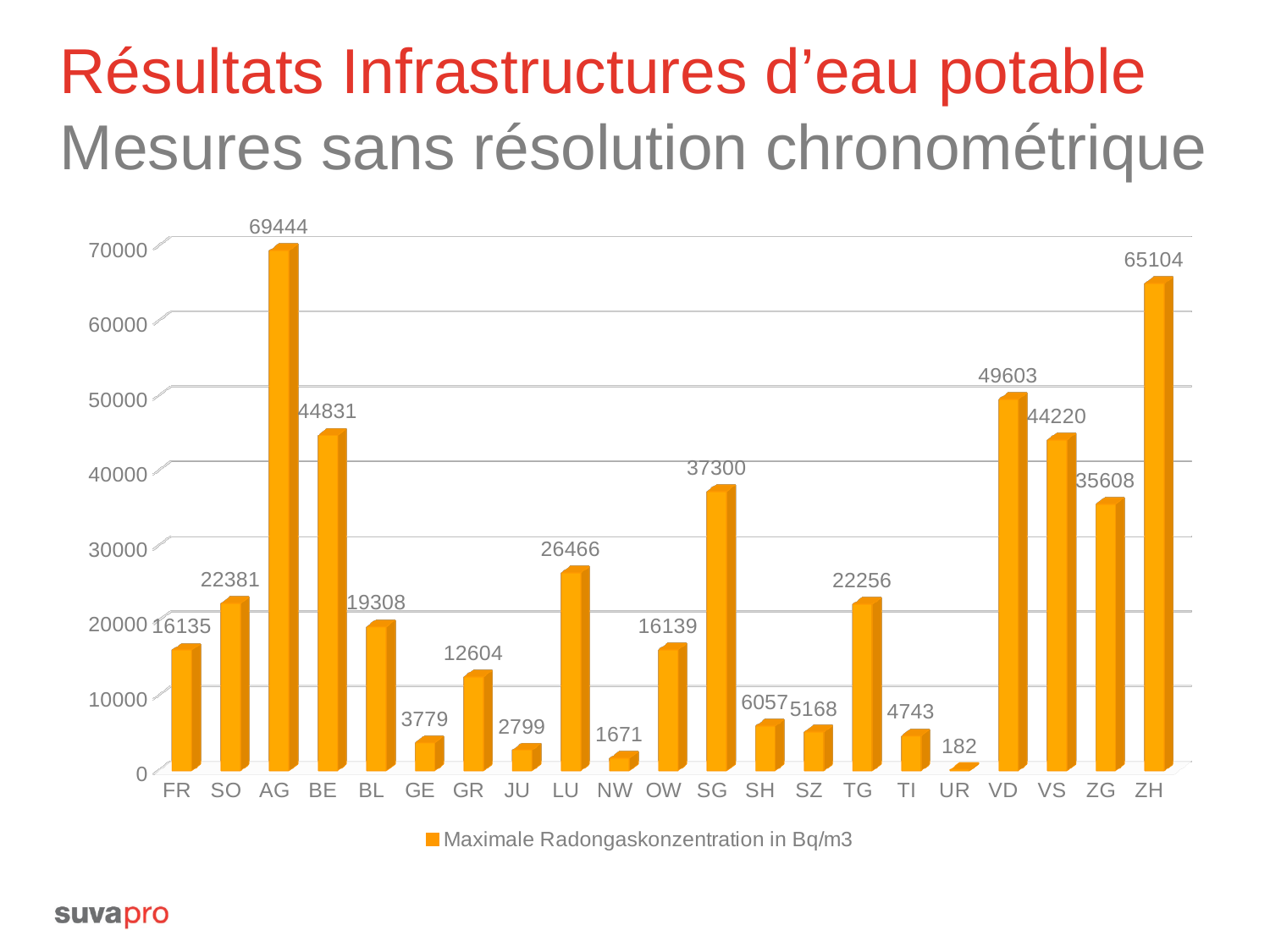
How many series does the legend list? 1 What is the difference between the values for AG and ZH? 4340 What is the difference between the values for VD and VS? 5383 Which category has the highest value? AG How many categories are shown on the x axis? 21 What is the value for SG? 37300 Which category has the lowest value? UR What is the value for AG? 69444 What is the value for UR? 182 Which has a larger value, SG or LU? SG What kind of chart is shown on the slide? bar chart Is the value for ZG greater or less than 30000? greater